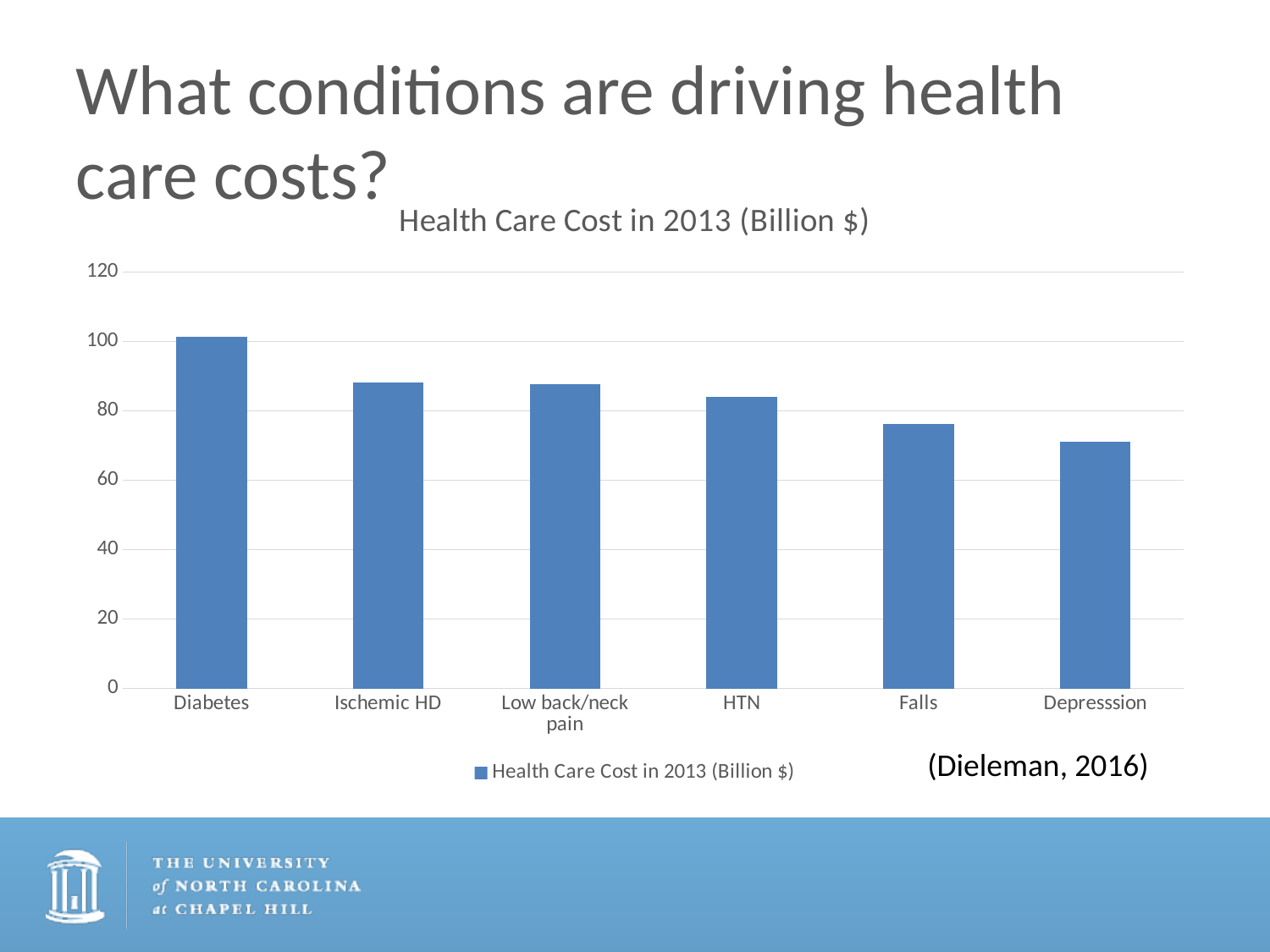
How many conditions are shown on the x axis of the chart? 6 Is the value for Depresssion greater or less than 80? less What is the title of the chart? Health Care Cost in 2013 (Billion $) Do the values rise or fall moving from left to right along the x axis? Fall Which is larger, the value for HTN or the value for Falls? HTN Is the value for Falls greater or less than 60? greater Which condition has the lowest health care cost in 2013? Depresssion How many series does the legend list? 1 What is the highest value shown on the y axis? 120 What kind of chart is shown on the slide? Bar chart Is the value for Diabetes greater or less than 100? greater Which condition has the highest health care cost in 2013? Diabetes